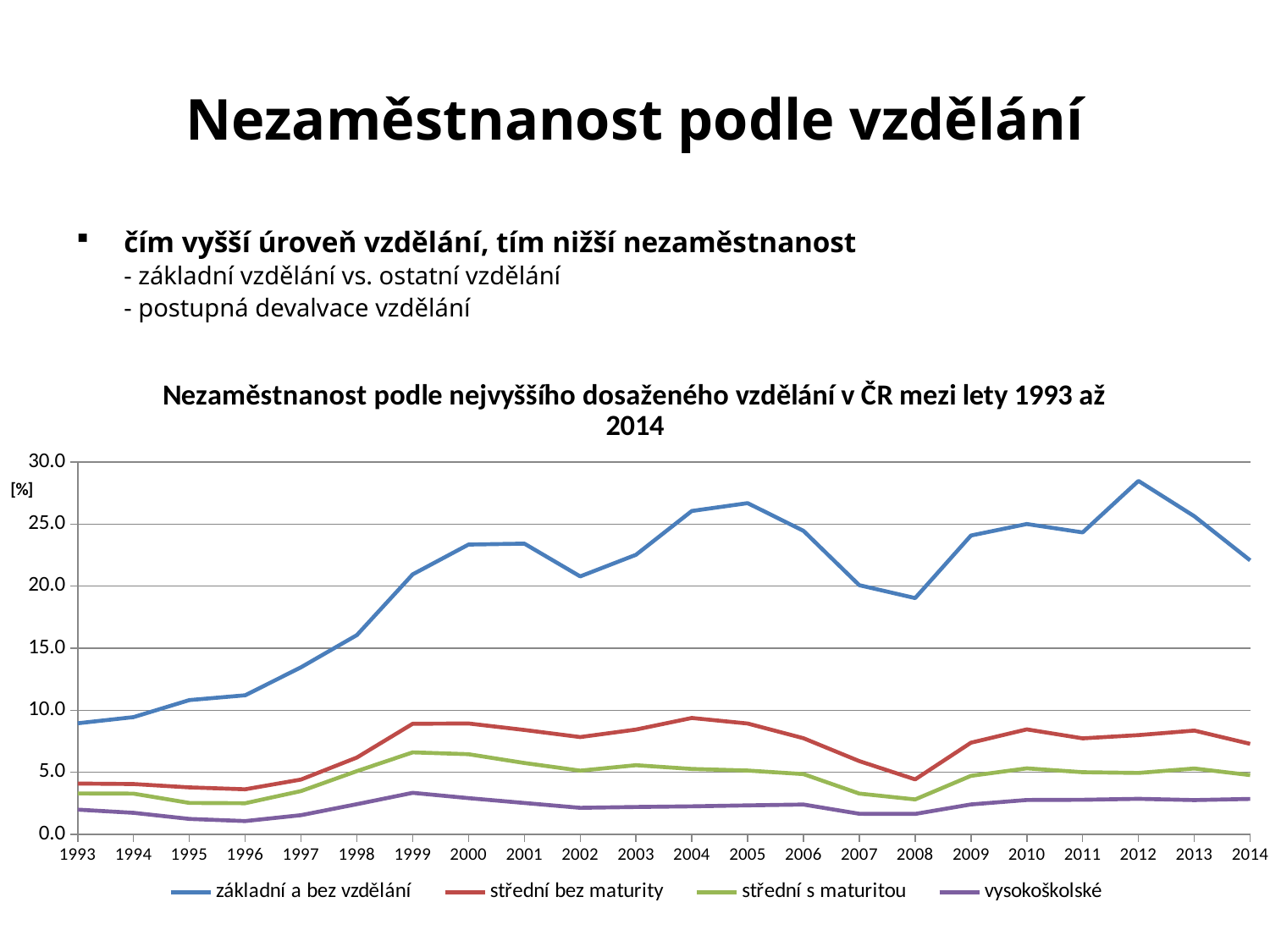
Does the 'základní a bez vzdělání' series rise or fall between 1993 and 1999? rise Is the value for 'základní a bez vzdělání' in 1993 greater or less than 10.0? less Is the value for 'vysokoškolské' in 2014 greater or less than 5.0? less What is the title of the chart? Nezaměstnanost podle nejvyššího dosaženého vzdělání v ČR mezi lety 1993 až 2014 Which series has the highest unemployment values across the whole period? základní a bez vzdělání Which series has the lowest unemployment values across the whole period? vysokoškolské How many years are plotted along the x axis? 22 Is the value for 'základní a bez vzdělání' in 2012 greater or less than 25.0? greater Which is larger for 'základní a bez vzdělání': the value in 2012 or the value in 2008? 2012 In which year does the 'základní a bez vzdělání' series reach its highest value? 2012 What kind of chart is shown on the slide? line chart How many series does the legend list? 4